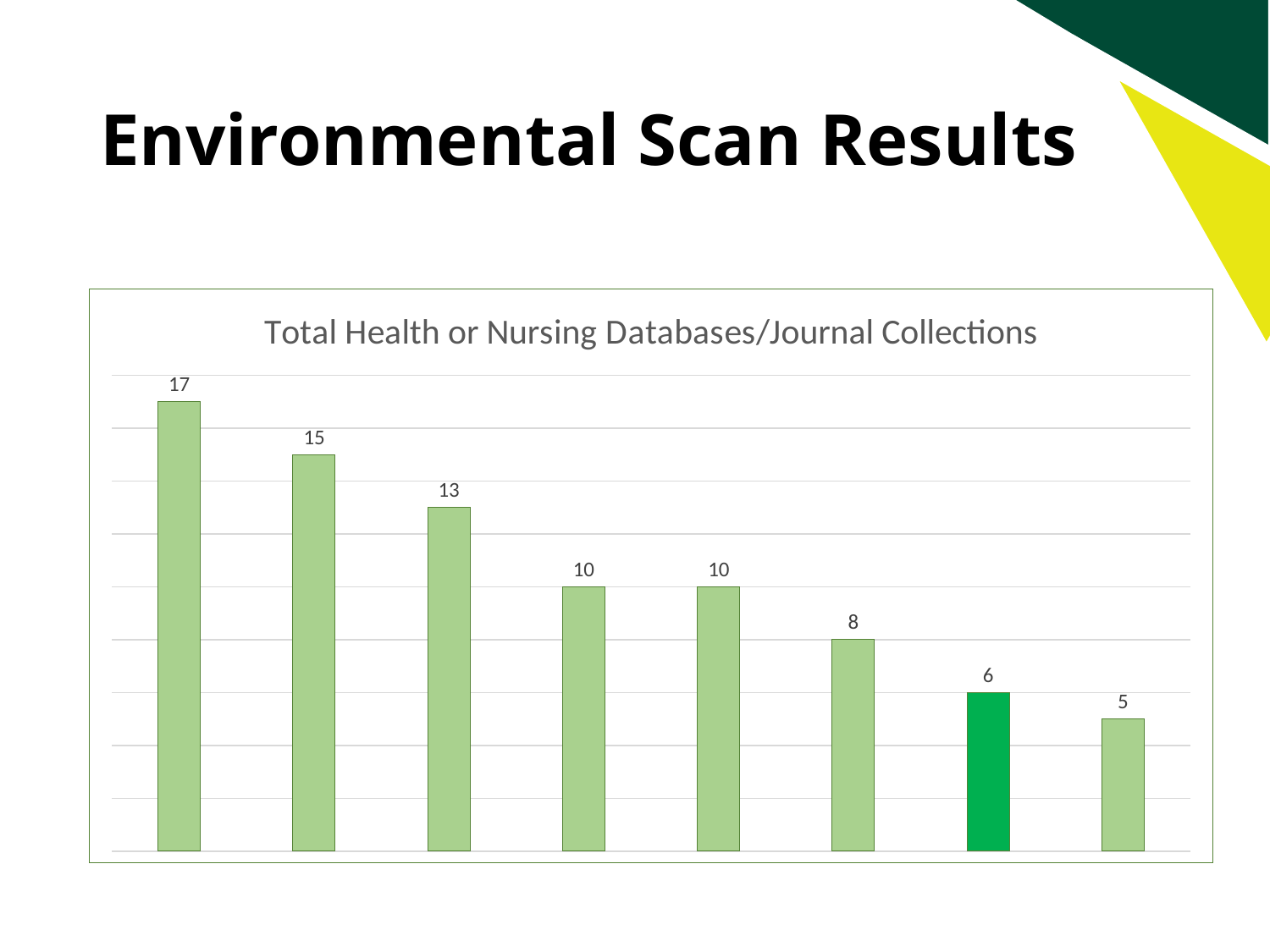
What is the value of the shortest bar in the chart? 5 Do the bar values rise or fall from left to right across the chart? fall What is the value of the tallest bar in the chart? 17 What is the difference between the second bar (15) and the sixth bar (8)? 7 What is the value of the third bar from the left? 13 What kind of chart is shown on the slide? bar chart What is the title of the chart? Total Health or Nursing Databases/Journal Collections What is the difference between the tallest bar (17) and the shortest bar (5)? 12 What is the value of the bar that is shaded a darker green than the others? 6 What is the value of the second bar from the left? 15 Which is larger, the value of the first bar or the value of the last bar? the first bar How many bars are plotted in the chart? 8